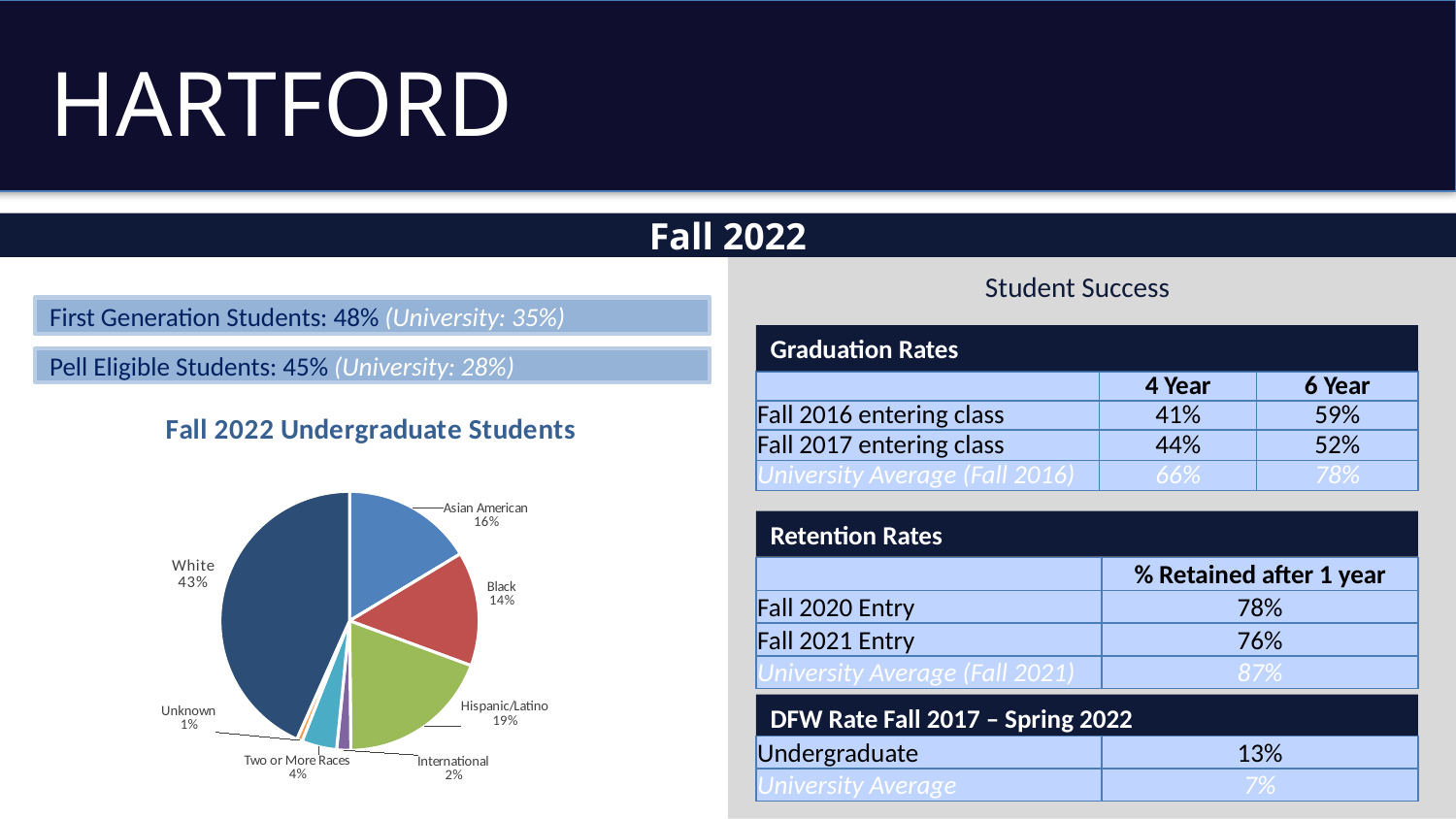
Which category has the smallest slice of the pie chart? Unknown What share of Fall 2022 undergraduate students is Hispanic/Latino? 19% What kind of chart is shown on the slide? pie chart What share of Fall 2022 undergraduate students is White? 43% What share of Fall 2022 undergraduate students is Black? 14% What share of Fall 2022 undergraduate students is Asian American? 16% Which is larger in the pie chart, the Asian American share or the Black share? Asian American What is the difference between the White share and the Hispanic/Latino share in the pie chart? 24% How many categories are shown in the pie chart? 7 What is the title of the pie chart? Fall 2022 Undergraduate Students What share of Fall 2022 undergraduate students is International? 2% Which category has the largest slice of the pie chart? White